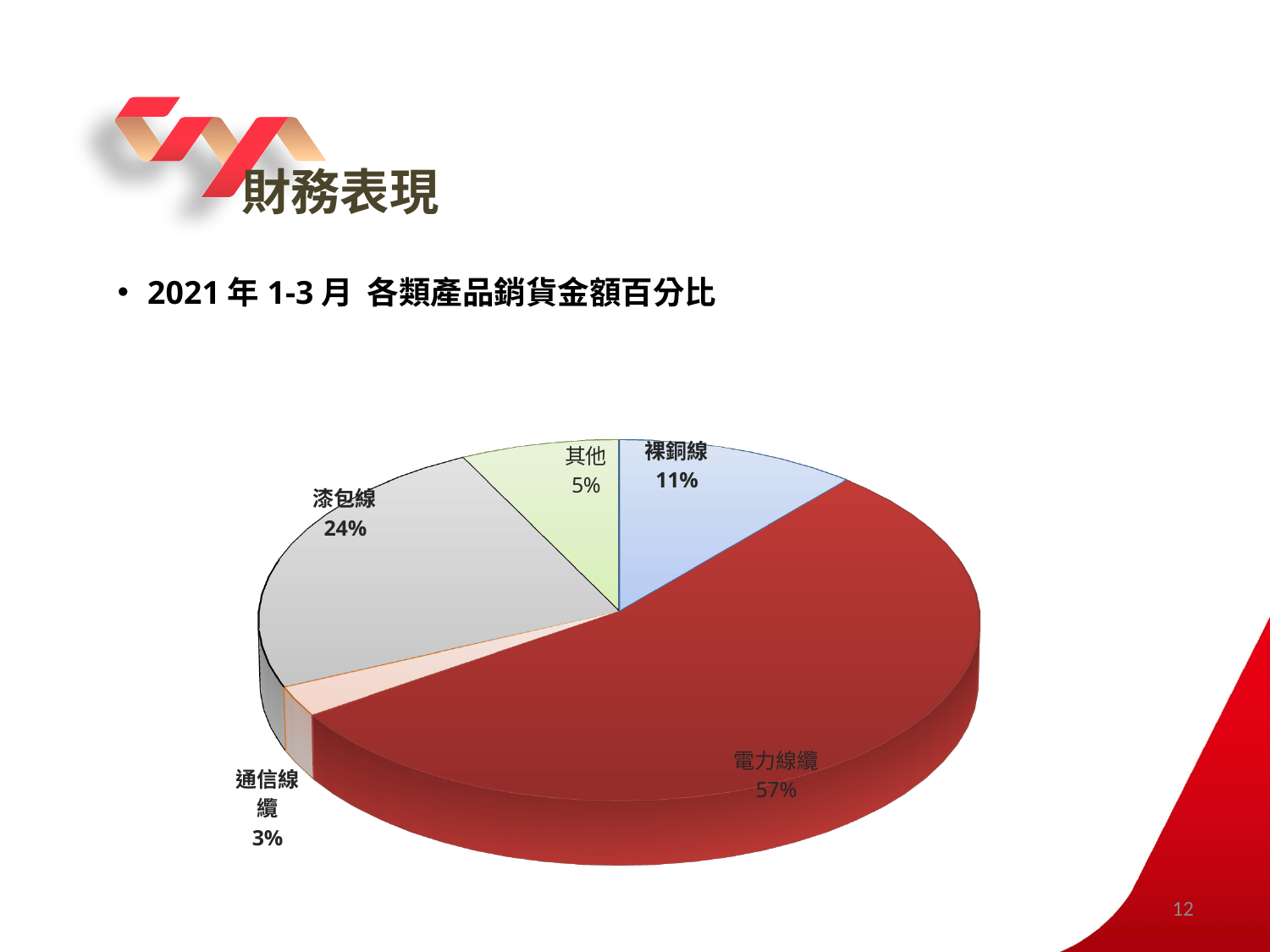
What kind of chart is shown on the slide? pie chart How many categories are shown in the pie chart? 5 Which category has the smallest share of the pie? 通信線纜 What percentage does 漆包線 account for? 24% Which is larger, the share of 裸銅線 or the share of 其他? 裸銅線 What is the difference in percentage points between 電力線纜 and 漆包線? 33 What percentage does 電力線纜 account for? 57% What percentage does 通信線纜 account for? 3% What is the combined share of 漆包線 and 裸銅線? 35% Which category has the largest share of the pie? 電力線纜 What percentage does 裸銅線 account for? 11% What percentage does 其他 account for? 5%